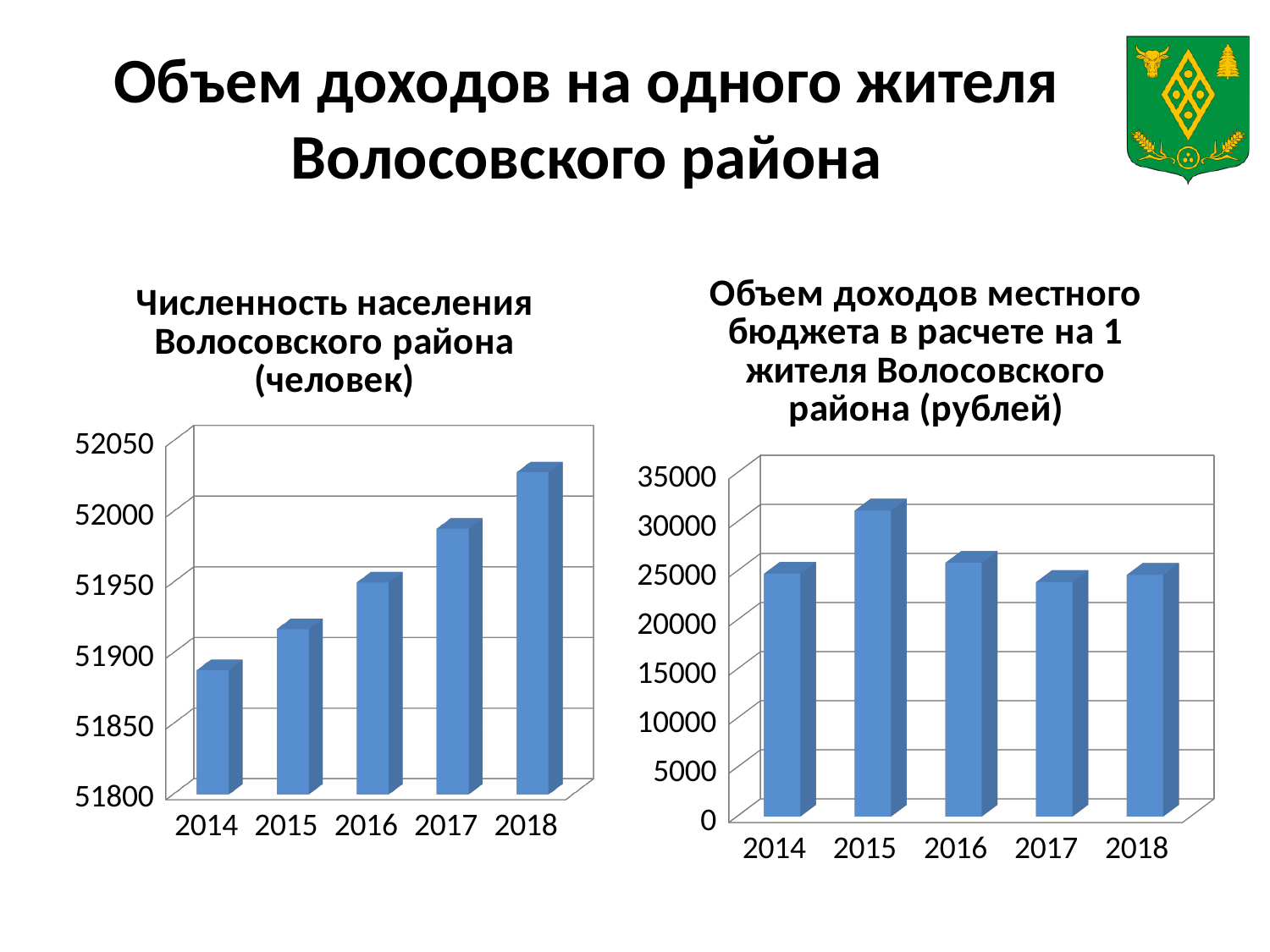
On the left chart, 'Численность населения Волосовского района (человек)', is the value for 2014 greater or less than 51900? less On the left chart, 'Численность населения Волосовского района (человек)', is the value for 2018 greater or less than 52000? greater What kind of chart is the left chart, 'Численность населения Волосовского района (человек)'? bar chart On the left chart, 'Численность населения Волосовского района (человек)', do the values rise or fall from 2014 to 2018? rise On the left chart, 'Численность населения Волосовского района (человек)', which year has the lowest value? 2014 How many years are shown on the left chart, 'Численность населения Волосовского района (человек)'? 5 On the right chart, 'Объем доходов местного бюджета в расчете на 1 жителя Волосовского района (рублей)', which year has the highest value? 2015 On the left chart, 'Численность населения Волосовского района (человек)', which year has the highest value? 2018 On the right chart, 'Объем доходов местного бюджета в расчете на 1 жителя Волосовского района (рублей)', is the value for 2015 greater or less than 30000? greater On the right chart, 'Объем доходов местного бюджета в расчете на 1 жителя Волосовского района (рублей)', which is larger, the value for 2015 or the value for 2016? 2015 On the right chart, 'Объем доходов местного бюджета в расчете на 1 жителя Волосовского района (рублей)', which year has the lowest value? 2017